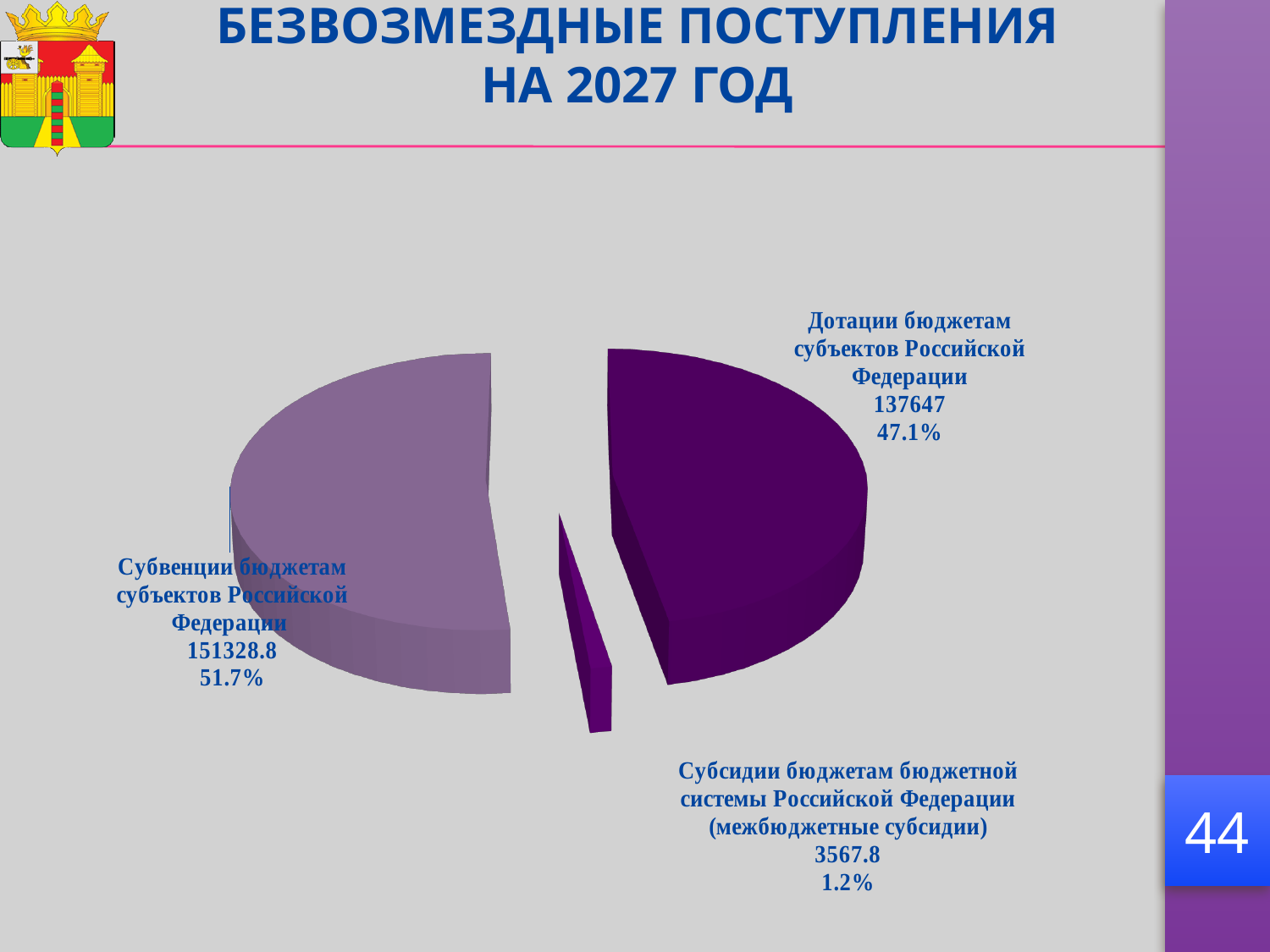
What share of the pie does Дотации бюджетам субъектов Российской Федерации represent? 47.1% What share of the pie does Субсидии бюджетам бюджетной системы Российской Федерации (межбюджетные субсидии) represent? 1.2% What is the value for Дотации бюджетам субъектов Российской Федерации? 137647 What is the title of the slide containing the chart? БЕЗВОЗМЕЗДНЫЕ ПОСТУПЛЕНИЯ НА 2027 ГОД What is the value for Субвенции бюджетам субъектов Российской Федерации? 151328.8 What type of chart is shown on the slide? Pie chart Which category has the largest slice of the pie? Субвенции бюджетам субъектов Российской Федерации What share of the pie does Субвенции бюджетам субъектов Российской Федерации represent? 51.7% What is the difference between the values for Субвенции бюджетам субъектов Российской Федерации and Дотации бюджетам субъектов Российской Федерации? 13681.8 How many slices does the pie chart have? 3 Which category has the smallest slice of the pie? Субсидии бюджетам бюджетной системы Российской Федерации (межбюджетные субсидии) What is the value for Субсидии бюджетам бюджетной системы Российской Федерации (межбюджетные субсидии)? 3567.8